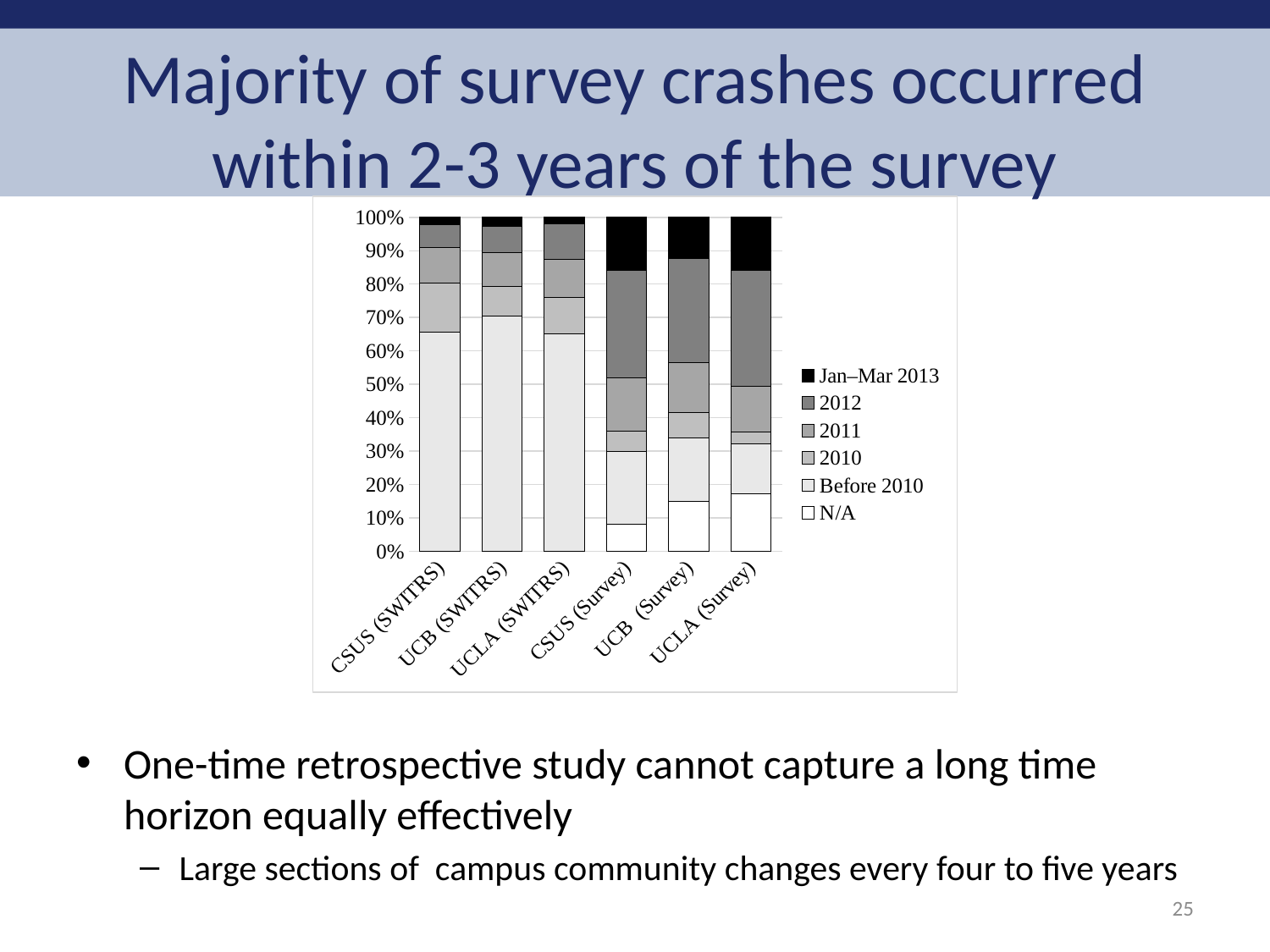
Which series is listed last in the chart's legend? N/A Which category has the largest 'Before 2010' share? UCB (SWITRS) Which has the larger 'Before 2010' share, UCB (SWITRS) or CSUS (Survey)? UCB (SWITRS) How many categories are shown along the x axis of the chart? 6 Is the 'Before 2010' share for UCB (SWITRS) greater or less than 60%? greater How many series does the chart's legend list? 6 Is the 'N/A' share for UCLA (Survey) greater or less than 10%? greater What kind of chart is shown on the slide? Stacked bar chart What is the total of the stacked bar for UCLA (Survey)? 100% Which series is shown in black in the chart's legend? Jan–Mar 2013 Which has the larger 'Jan–Mar 2013' share, CSUS (SWITRS) or CSUS (Survey)? CSUS (Survey) Is the 'N/A' share for CSUS (Survey) greater or less than 10%? less